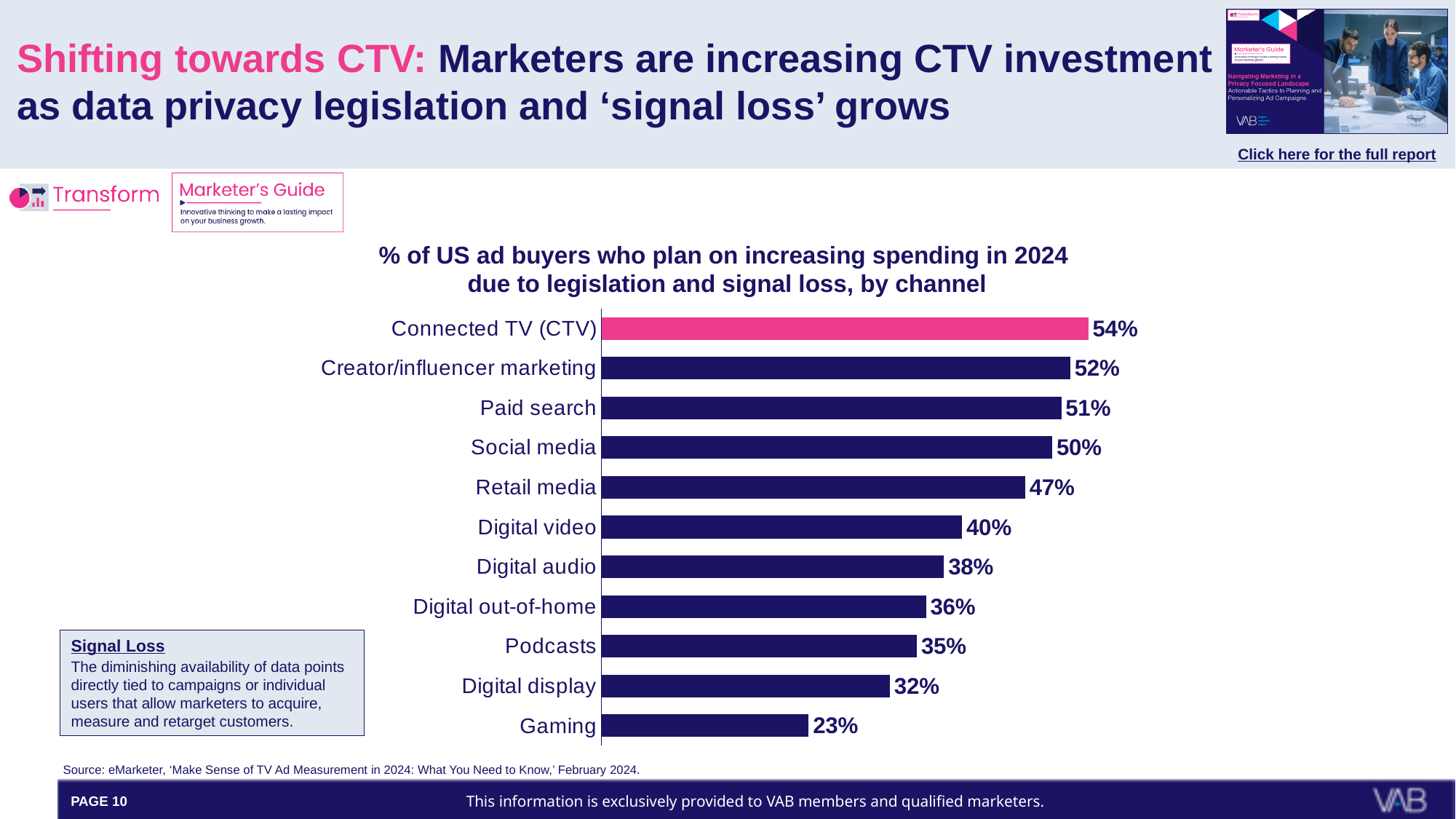
Which bar is highlighted in pink rather than dark blue? Connected TV (CTV) Which channel has the lowest percentage? Gaming What is the difference in percentage points between Connected TV (CTV) and Gaming? 31 Which channel has the highest percentage of ad buyers planning to increase spending? Connected TV (CTV) What percentage of US ad buyers plan on increasing spending on Connected TV (CTV)? 54% What is the title of the chart? % of US ad buyers who plan on increasing spending in 2024 due to legislation and signal loss, by channel What is the value shown for Podcasts? 35% What is the value shown for Retail media? 47% What kind of chart is shown on the slide? Bar chart Which is larger, the value for Social media or the value for Digital audio? Social media How many channels are shown in the chart? 11 What is the difference in percentage points between Digital video and Digital display? 8